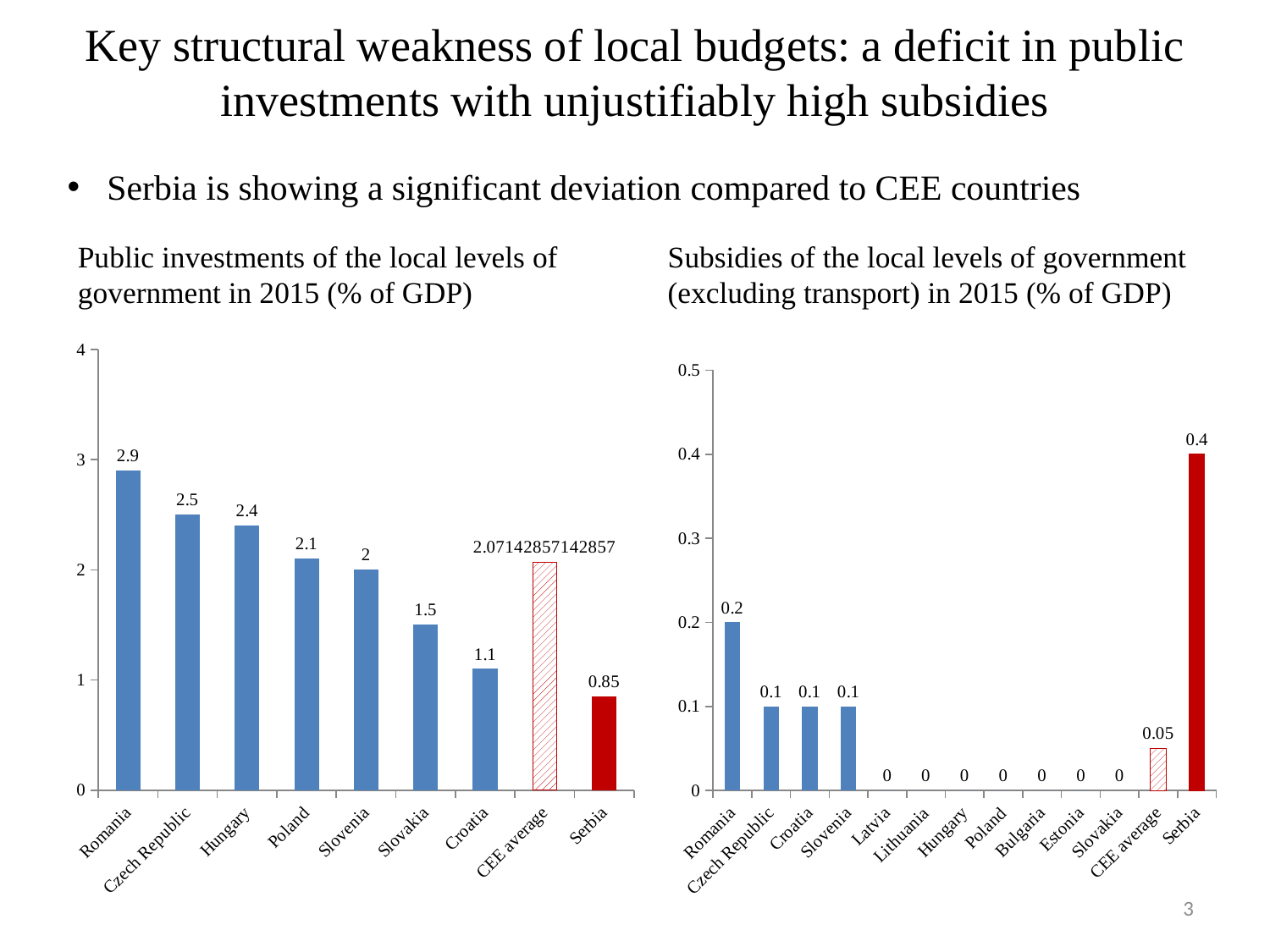
In the chart 'Subsidies of the local levels of government (excluding transport) in 2015 (% of GDP)', which category has the highest value? Serbia In the chart 'Subsidies of the local levels of government (excluding transport) in 2015 (% of GDP)', what is the value for CEE average? 0.05 In the chart 'Subsidies of the local levels of government (excluding transport) in 2015 (% of GDP)', what is the value for Serbia? 0.4 In the chart 'Public investments of the local levels of government in 2015 (% of GDP)', what is the value for Romania? 2.9 In the chart 'Subsidies of the local levels of government (excluding transport) in 2015 (% of GDP)', how many categories are shown on the x axis? 13 In the chart 'Public investments of the local levels of government in 2015 (% of GDP)', what is the difference between the values for Czech Republic and Croatia? 1.4 In the chart 'Public investments of the local levels of government in 2015 (% of GDP)', which country has the lowest value? Serbia In the chart 'Public investments of the local levels of government in 2015 (% of GDP)', is the value for Slovakia greater or less than 2? less In the chart 'Public investments of the local levels of government in 2015 (% of GDP)', how many categories are shown on the x axis? 9 In the chart 'Public investments of the local levels of government in 2015 (% of GDP)', which category has the highest value? Romania What kind of chart is the chart 'Subsidies of the local levels of government (excluding transport) in 2015 (% of GDP)'? Bar chart In the chart 'Public investments of the local levels of government in 2015 (% of GDP)', what is the value for Serbia? 0.85